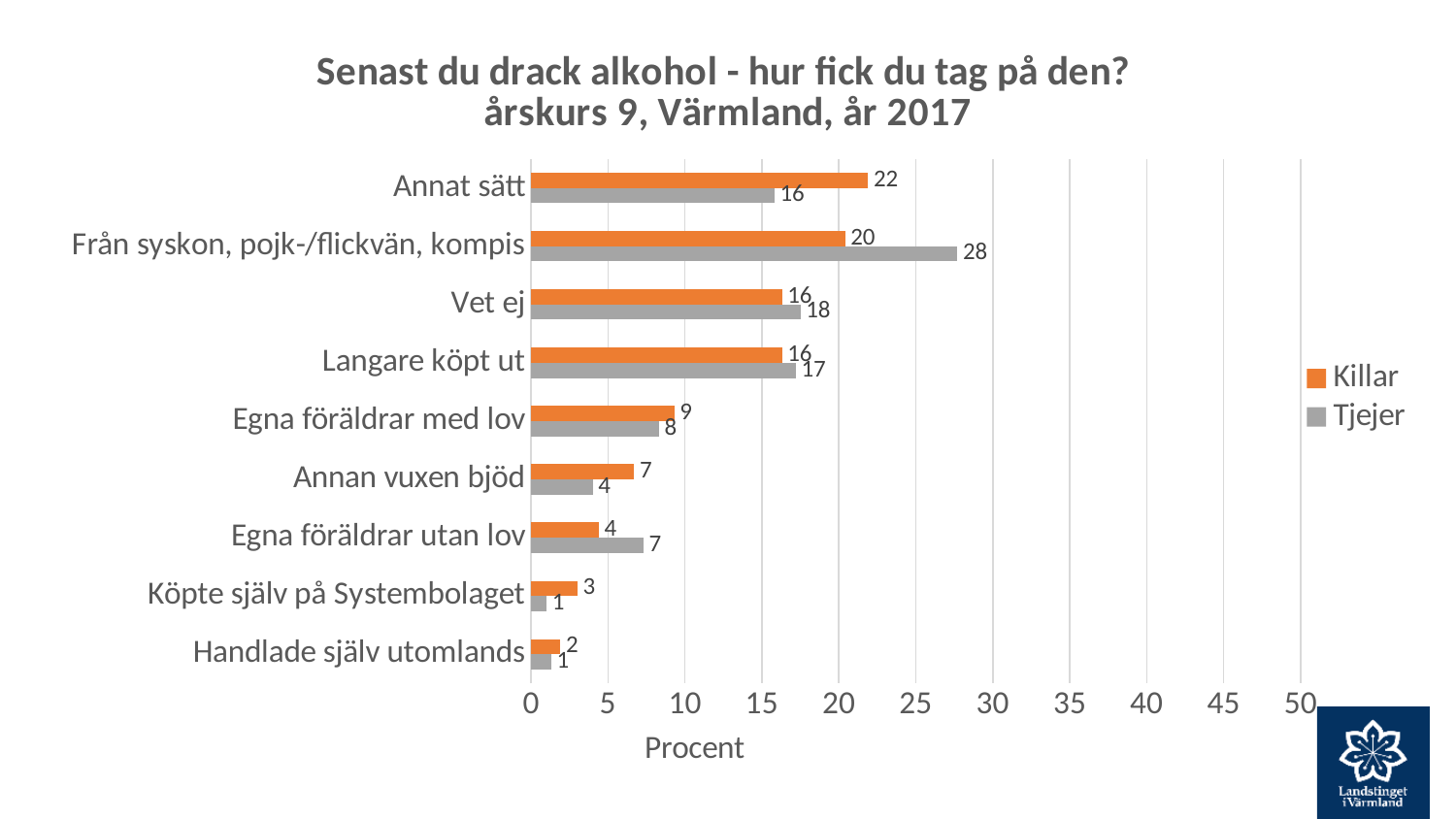
What is the label of the x axis? Procent What kind of chart is shown on the slide? Bar chart How many series does the legend list? 2 What is the value for Tjejer in the category 'Egna föräldrar utan lov'? 7 Is the value for Killar in 'Annat sätt' greater or less than 20? greater Which category has the lowest value for Killar? Handlade själv utomlands Which category has the highest value for Tjejer? Från syskon, pojk-/flickvän, kompis How many categories are shown on the chart? 9 What is the value for Killar in the category 'Annat sätt'? 22 Which is larger in the category 'Annan vuxen bjöd', the value for Killar or for Tjejer? Killar What is the difference between the Tjejer and Killar values for 'Från syskon, pojk-/flickvän, kompis'? 8 What is the value for Tjejer in the category 'Från syskon, pojk-/flickvän, kompis'? 28